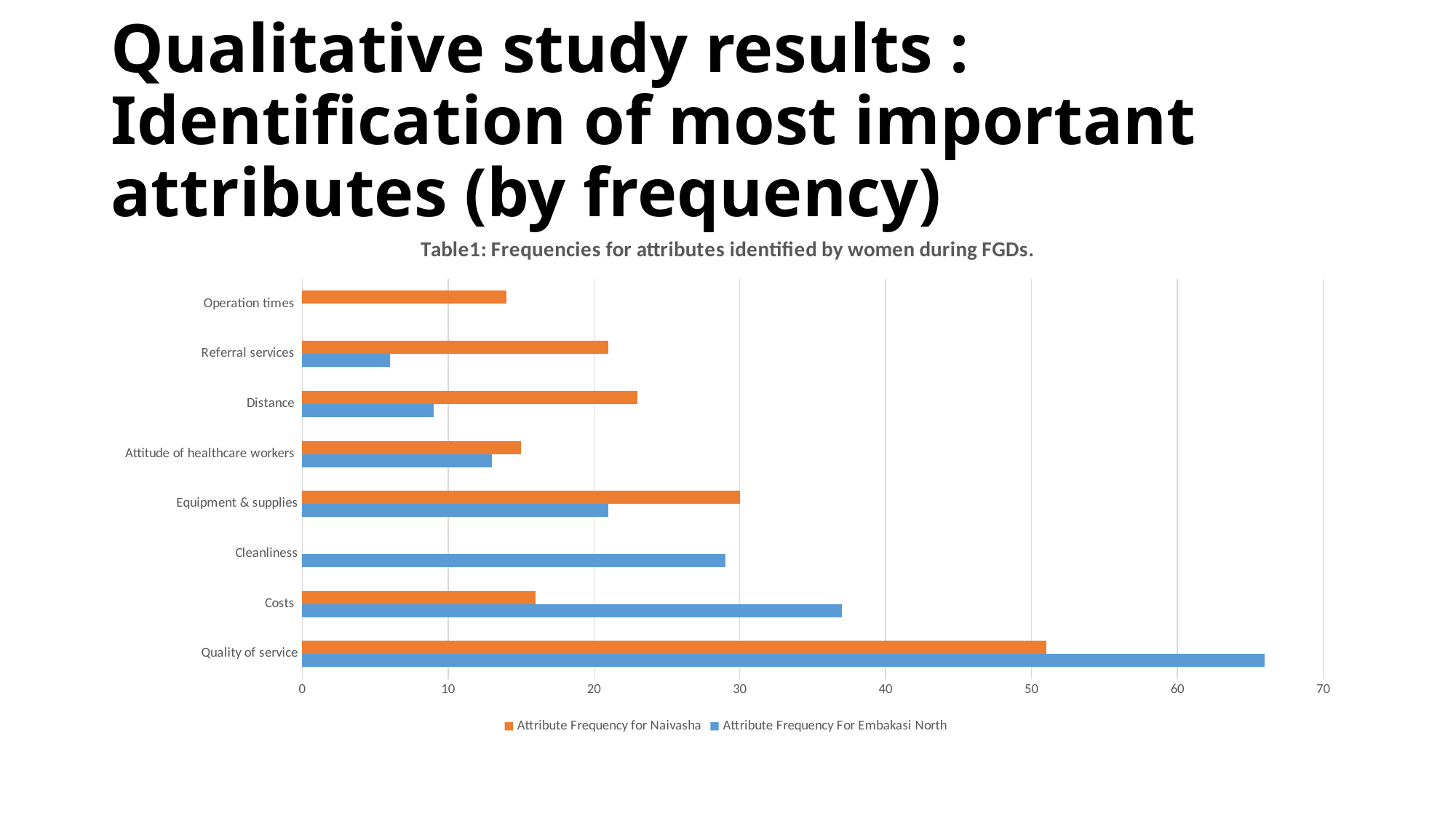
Is the Attribute Frequency For Embakasi North for Costs greater or less than 30? greater Is the Attribute Frequency for Naivasha for Operation times greater or less than 20? less What kind of chart is shown on the slide? bar chart Which attribute has the highest Attribute Frequency for Naivasha? Quality of service For Distance, which series has the larger value: Attribute Frequency for Naivasha or Attribute Frequency For Embakasi North? Attribute Frequency for Naivasha How many series does the legend list? 2 How many attribute categories are shown on the y axis? 8 Is the Attribute Frequency For Embakasi North for Quality of service greater or less than 60? greater For Costs, which series has the larger value: Attribute Frequency for Naivasha or Attribute Frequency For Embakasi North? Attribute Frequency For Embakasi North Which attribute has the highest Attribute Frequency For Embakasi North? Quality of service What is the title of the chart? Table1: Frequencies for attributes identified by women during FGDs.